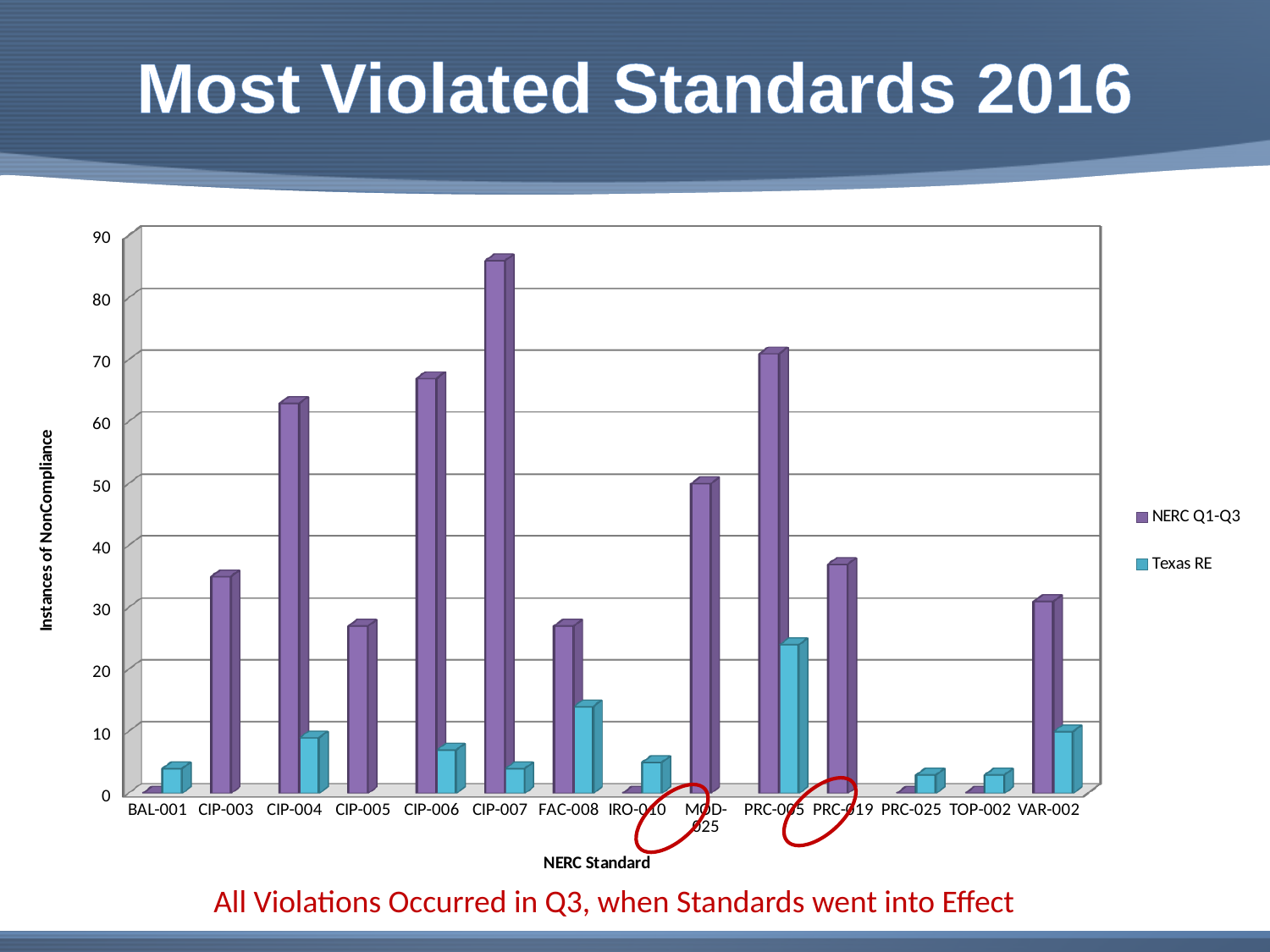
Is the NERC Q1-Q3 value for PRC-005 greater or less than 60? greater Which is larger, the Texas RE value for FAC-008 or for CIP-007? FAC-008 How many NERC standards are listed along the x axis? 14 How many series does the legend list? 2 Which is larger, the NERC Q1-Q3 value for CIP-004 or for CIP-005? CIP-004 Is the NERC Q1-Q3 value for CIP-007 greater or less than 80? greater Is the Texas RE value for PRC-005 greater or less than 20? greater Which NERC standard has the highest Texas RE value? PRC-005 What is the title of the y axis? Instances of NonCompliance Which NERC standard has the highest NERC Q1-Q3 value? CIP-007 What kind of chart is shown on the slide? bar chart